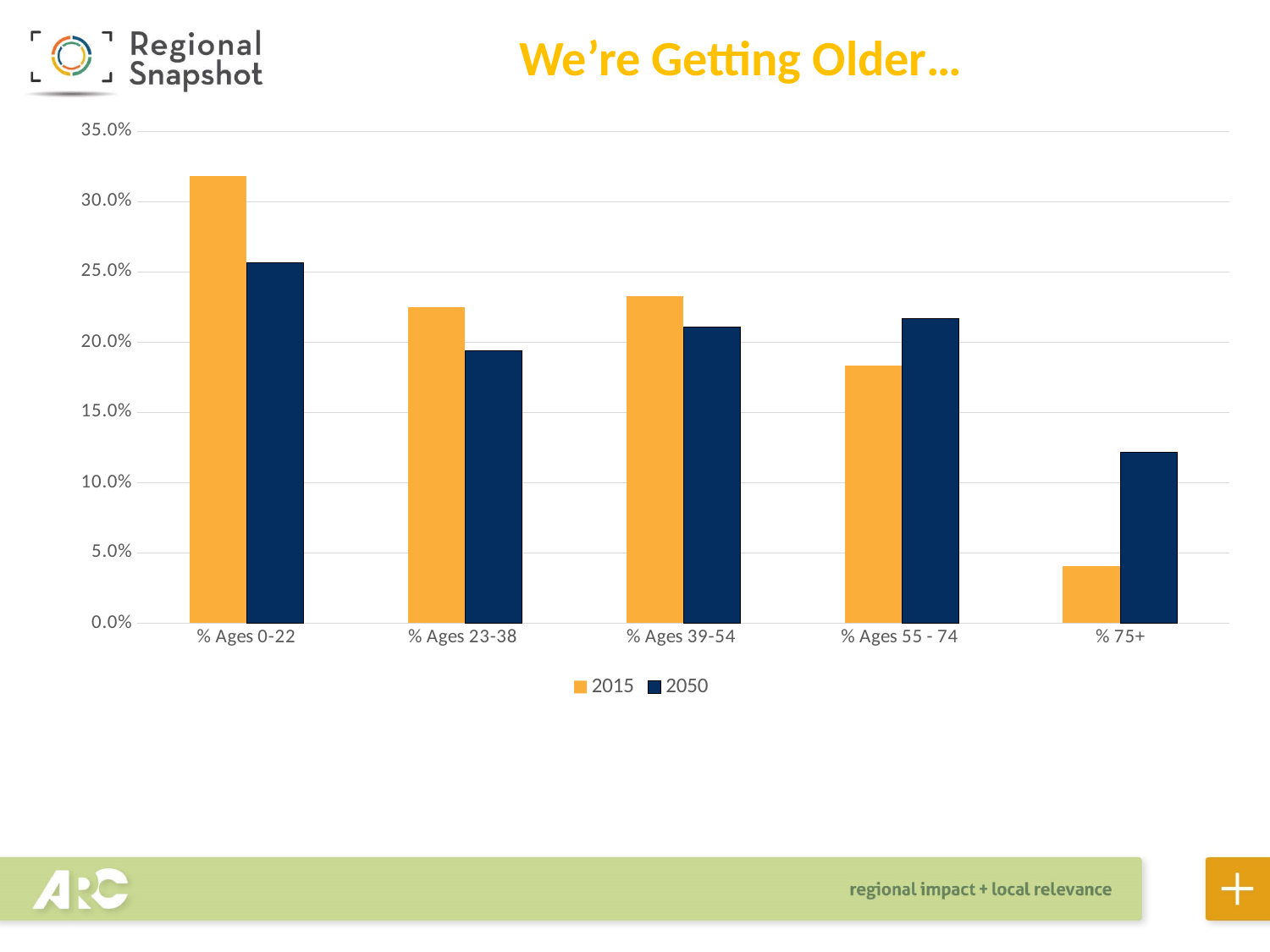
For % 75+, which series is larger, 2015 or 2050? 2050 Which age category has the lowest value for 2050? % 75+ Which age category has the highest value for 2015? % Ages 0-22 For % Ages 0-22, which series is larger, 2015 or 2050? 2015 Which age category has the lowest value for 2015? % 75+ What is the title of the slide containing the chart? We're Getting Older... What kind of chart is shown on the slide? bar chart How many series does the legend list? 2 Is the 2015 value for % Ages 0-22 greater or less than 30.0%? greater How many age categories are shown on the x axis? 5 Is the 2050 value for % 75+ greater or less than 10.0%? greater Is the 2015 value for % Ages 55 - 74 greater or less than 20.0%? less